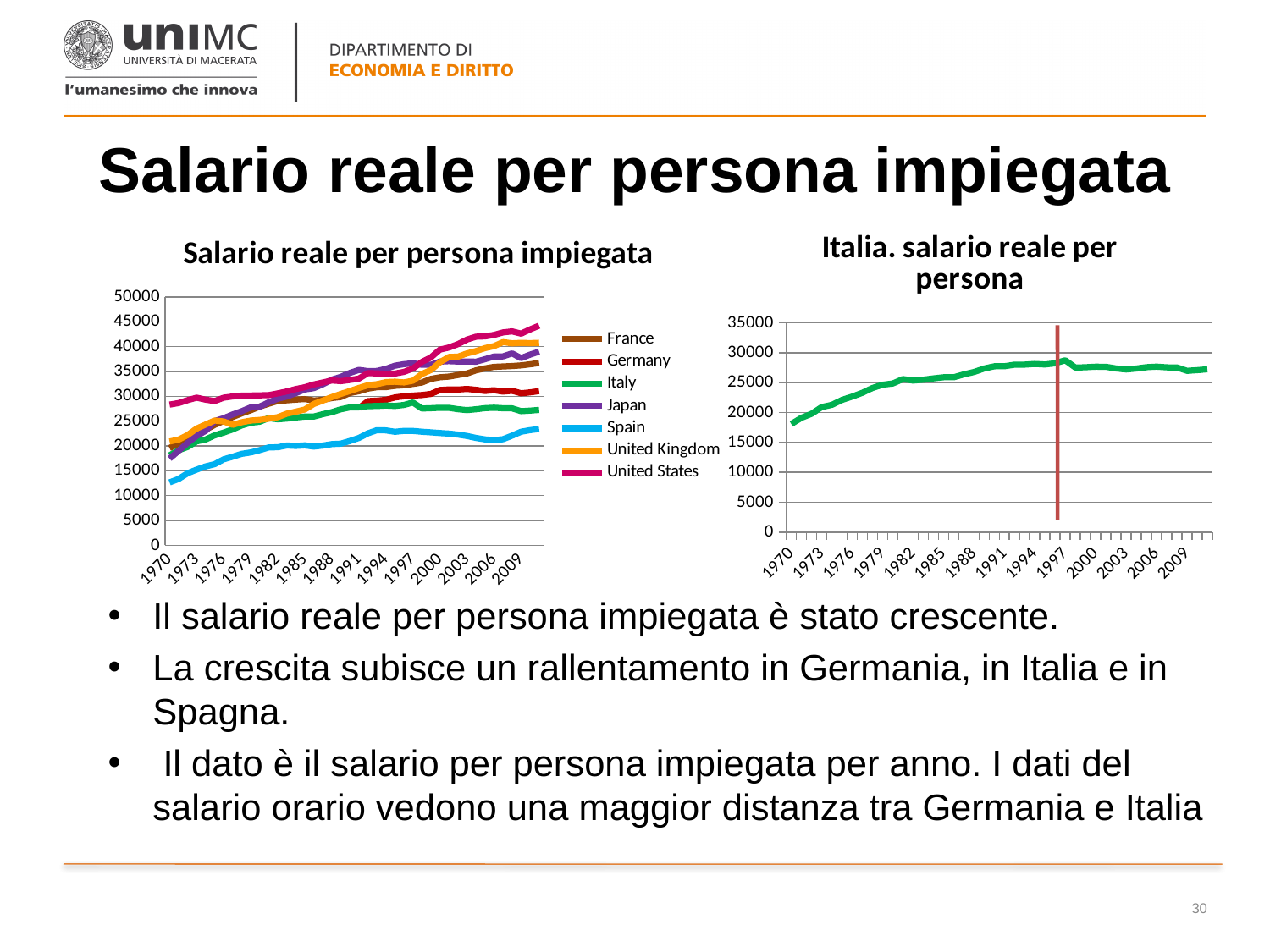
In the left chart "Salario reale per persona impiegata", is the value for United States in 2010 greater or less than 40000? greater In the right chart "Italia. salario reale per persona", do the values generally rise or fall from 1970 to 1990? rise In the left chart "Salario reale per persona impiegata", which country has the highest value at the end of the period (2010)? United States What kind of chart is the left chart titled "Salario reale per persona impiegata"? line chart In the right chart "Italia. salario reale per persona", at which year is the red vertical line placed? 1997 In the right chart "Italia. salario reale per persona", is the value in 1970 greater or less than 20000? less How many series does the legend of the left chart "Salario reale per persona impiegata" list? 7 In the left chart "Salario reale per persona impiegata", which is larger in 2010, the value for Japan or the value for Germany? Japan What is the title of the right chart? Italia. salario reale per persona In the left chart "Salario reale per persona impiegata", is the value for Italy in 2010 greater or less than 30000? less In the left chart "Salario reale per persona impiegata", which country has the lowest value throughout the period? Spain